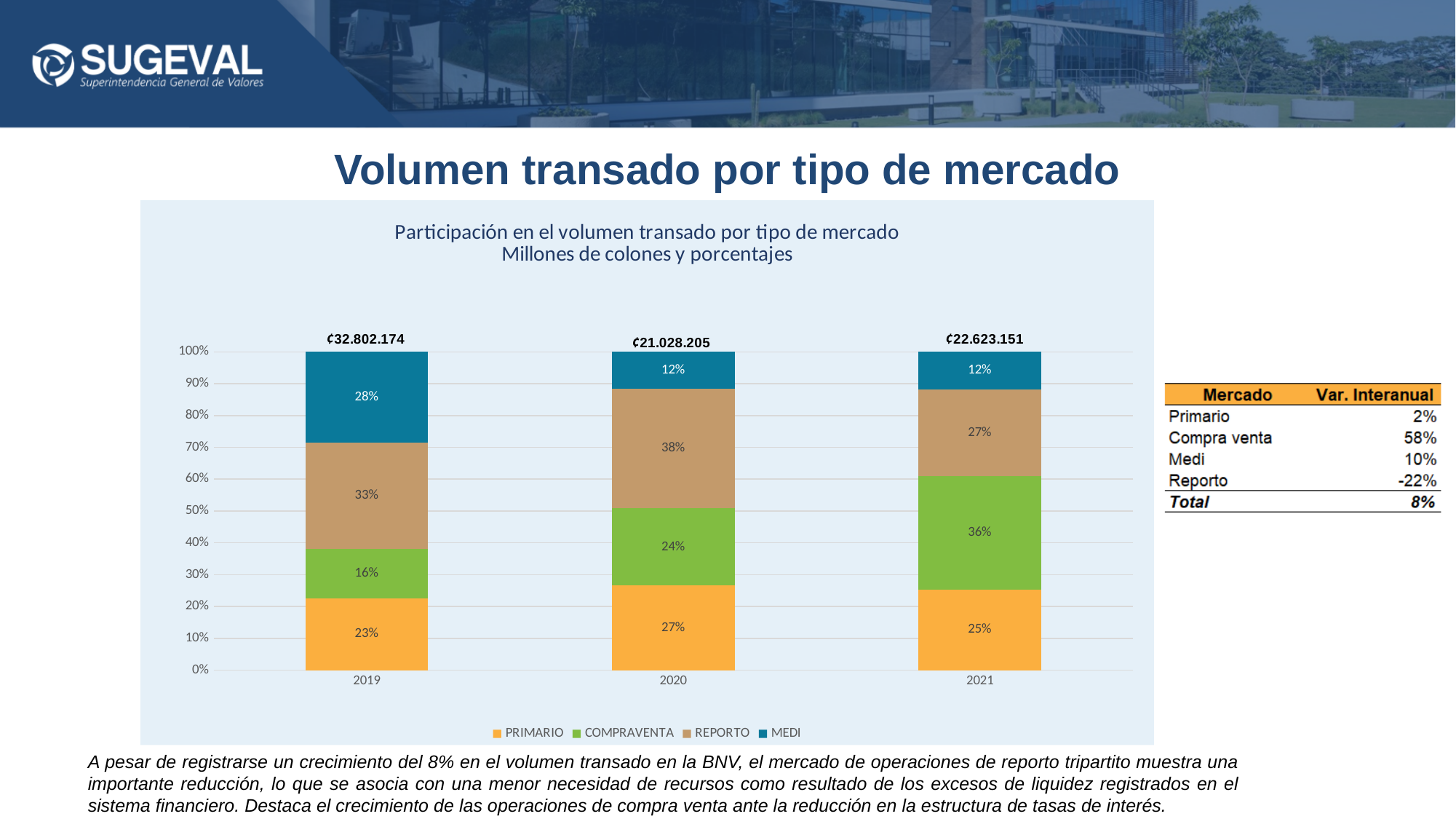
What is the share of COMPRAVENTA in 2021? 36% Which is larger in 2021, the REPORTO share or the COMPRAVENTA share? COMPRAVENTA In which year is the COMPRAVENTA share lowest? 2019 What total volume is printed above the 2019 bar? ₡32.802.174 In which year is the PRIMARIO share highest? 2020 What total volume is printed above the 2020 bar? ₡21.028.205 How many years are shown on the x axis? 3 What is the difference between the REPORTO share in 2020 and in 2021? 11 percentage points How many series does the legend list? 4 What is the share of REPORTO in 2020? 38% What kind of chart is shown? Stacked bar chart What is the share of MEDI in 2019? 28%